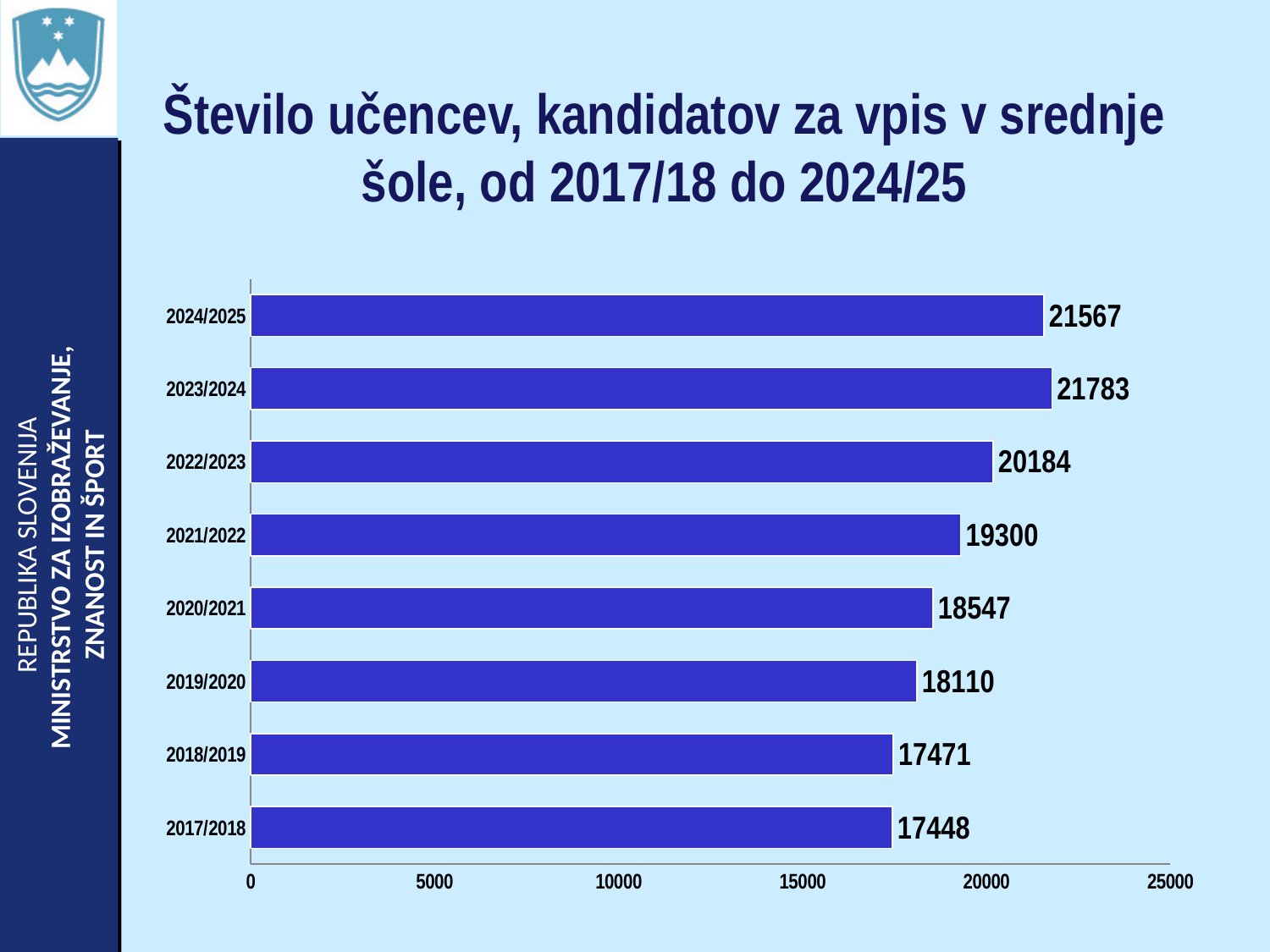
Do the values generally rise or fall from 2017/2018 to 2023/2024? rise What is the value for 2024/2025? 21567 What is the value for 2020/2021? 18547 How many school years are shown in the chart? 8 What is the value for 2017/2018? 17448 What is the difference between the values for 2022/2023 and 2021/2022? 884 Is the value for 2021/2022 greater or less than 15000? greater What type of chart is shown on the slide? bar chart Which school year has the highest value? 2023/2024 What is the difference between the values for 2023/2024 and 2024/2025? 216 Which is larger, the value for 2019/2020 or the value for 2018/2019? 2019/2020 Which school year has the lowest value? 2017/2018